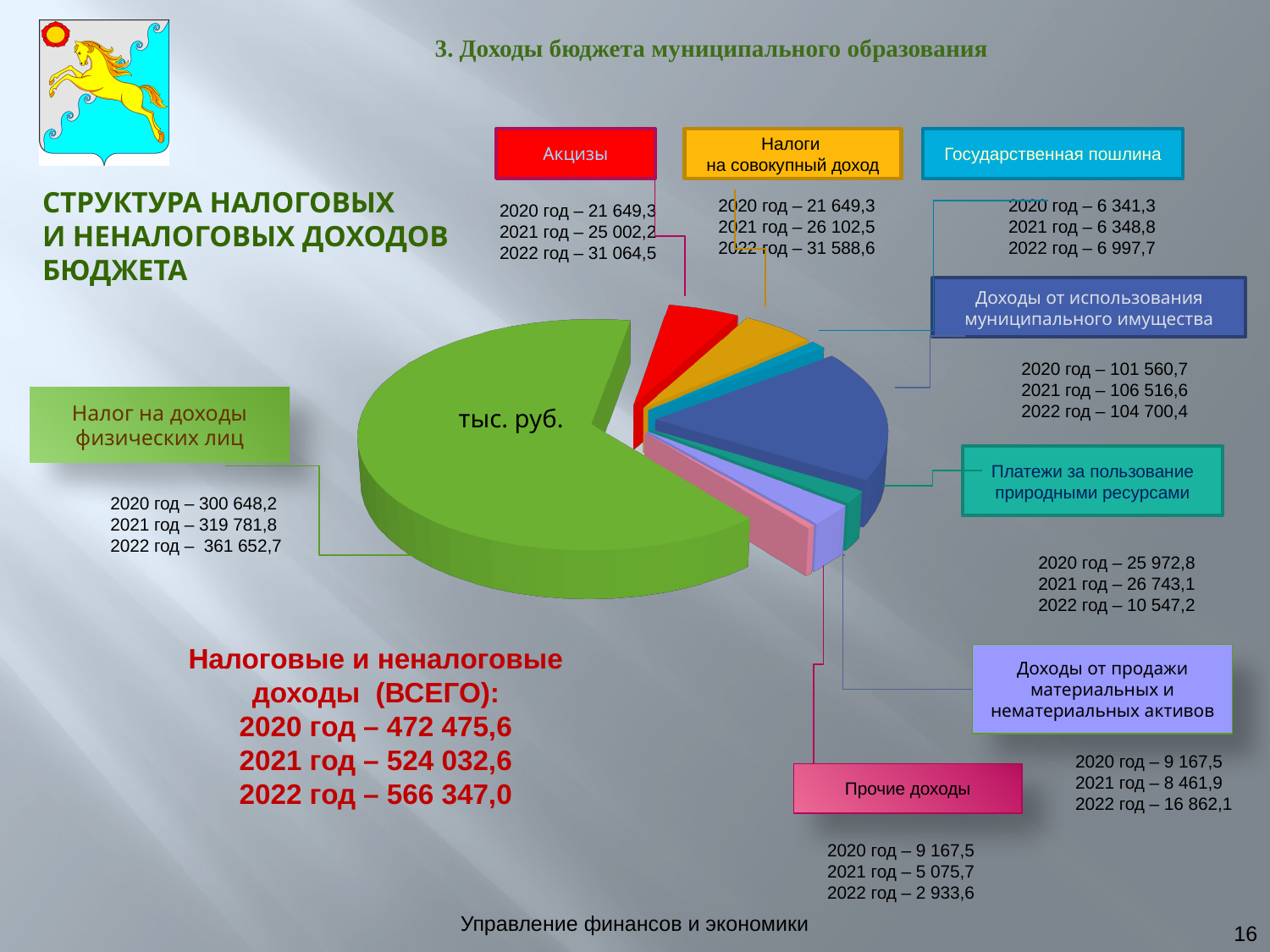
Which category has the largest slice of the pie chart? Налог на доходы физических лиц How many revenue categories (slices) does the pie chart show? 8 What unit is printed in the centre of the pie chart? тыс. руб. What is the value for Государственная пошлина in 2020? 6 341,3 In 2022, which is larger: Доходы от использования муниципального имущества or Платежи за пользование природными ресурсами? Доходы от использования муниципального имущества What is the value for Налог на доходы физических лиц in 2022? 361 652,7 By how much did Прочие доходы decrease from 2020 to 2022? 6 233,9 Do the values for Налог на доходы физических лиц rise or fall from 2020 to 2022? Rise What is the total of tax and non-tax revenues (Налоговые и неналоговые доходы ВСЕГО) for 2022? 566 347,0 What kind of chart is shown on the slide? Pie chart What is the value for Доходы от продажи материальных и нематериальных активов in 2022? 16 862,1 What is the value for Акцизы in 2021? 25 002,2